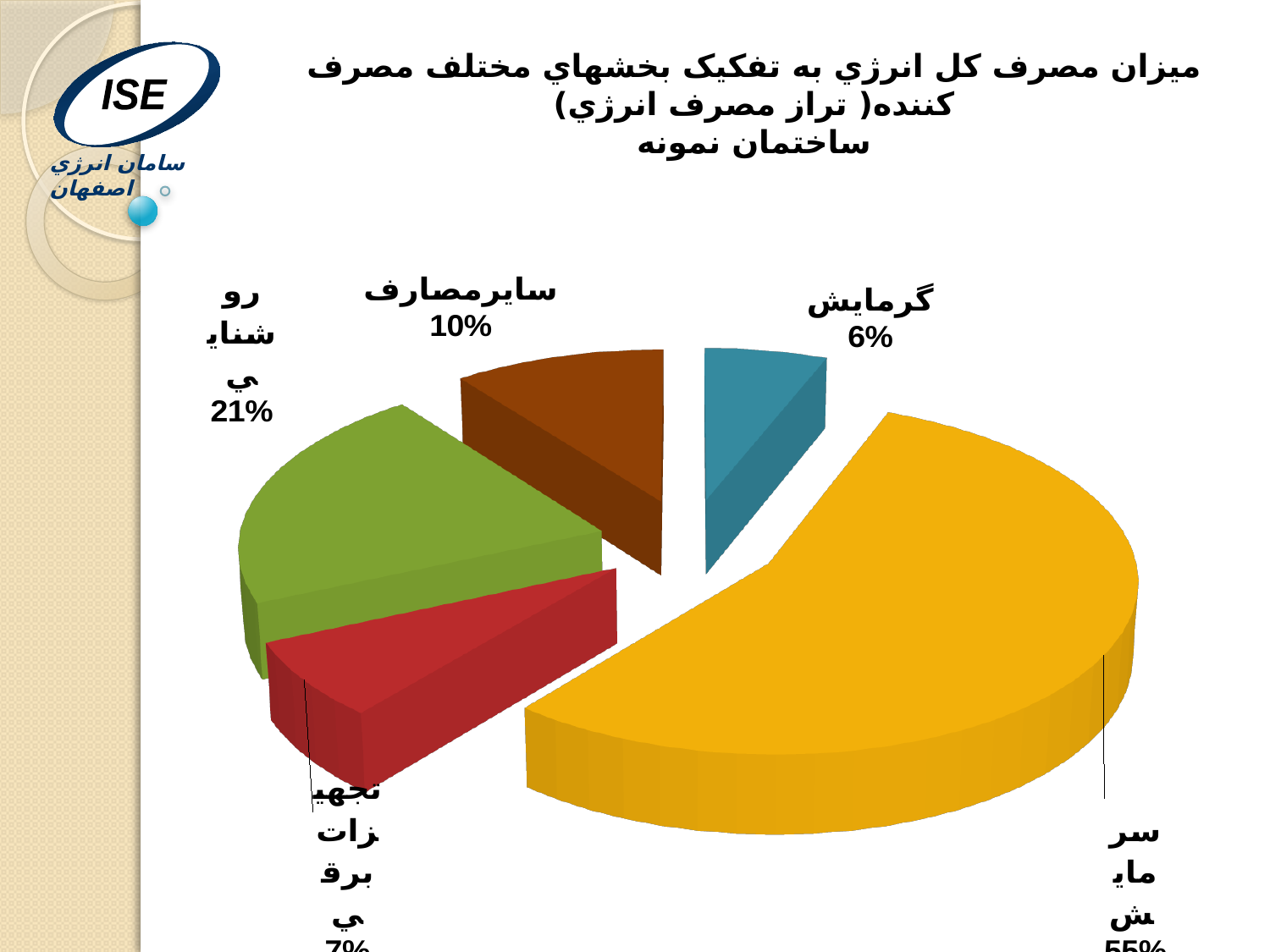
What kind of chart is shown on the slide? pie chart What share of total energy consumption does گرمایش account for? 6% What is the difference in percentage points between سایرمصارف and گرمایش? 4% What share of total energy consumption does سایرمصارف account for? 10% How many slices does the pie chart have? 5 What is the difference in percentage points between روشنایی and گرمایش? 15% What share of total energy consumption does سرمایش account for? 55% Which is larger, the share for روشنایی or the share for سایرمصارف? روشنایی Which category has the largest slice of the pie? سرمایش Which category has the smallest slice of the pie? گرمایش What colour is the slice for سرمایش? yellow